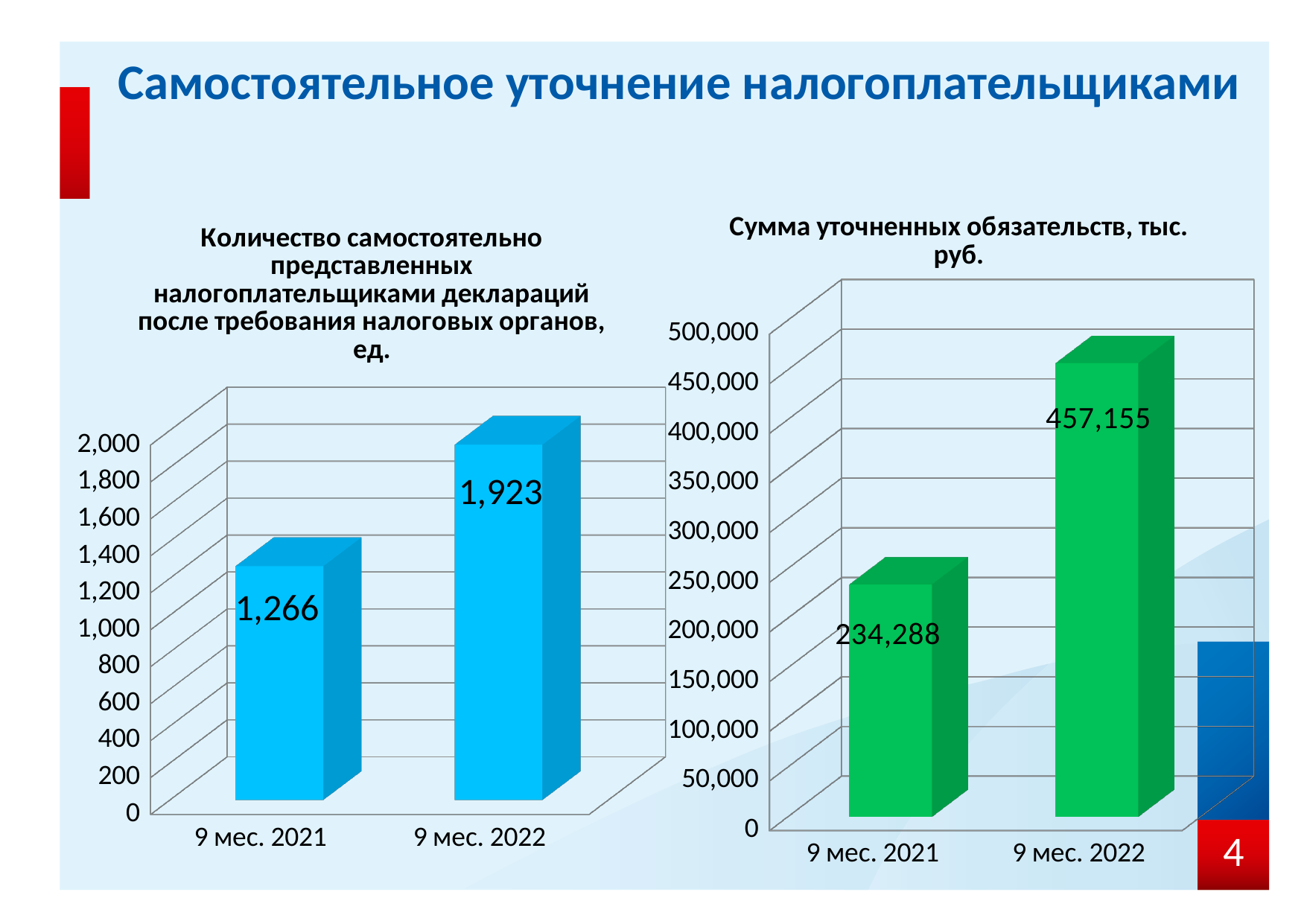
In the left chart (Количество самостоятельно представленных налогоплательщиками деклараций), what is the value for 9 мес. 2022? 1,923 In the right chart, what is the difference between the values for 9 мес. 2022 and 9 мес. 2021? 222,867 What type of chart is the right chart (Сумма уточненных обязательств, тыс. руб.)? bar chart In the right chart (Сумма уточненных обязательств, тыс. руб.), what is the value for 9 мес. 2021? 234,288 In the left chart, what is the difference between the values for 9 мес. 2022 and 9 мес. 2021? 657 In the right chart, do the values rise or fall from 9 мес. 2021 to 9 мес. 2022? rise In the left chart, which period has the higher value? 9 мес. 2022 In the left chart (Количество самостоятельно представленных налогоплательщиками деклараций), what is the value for 9 мес. 2021? 1,266 In the right chart (Сумма уточненных обязательств, тыс. руб.), what is the value for 9 мес. 2022? 457,155 In the right chart, is the value for 9 мес. 2022 greater or less than 400,000? greater In the right chart, which period has the lowest value? 9 мес. 2021 How many categories are shown on the x axis of the left chart? 2